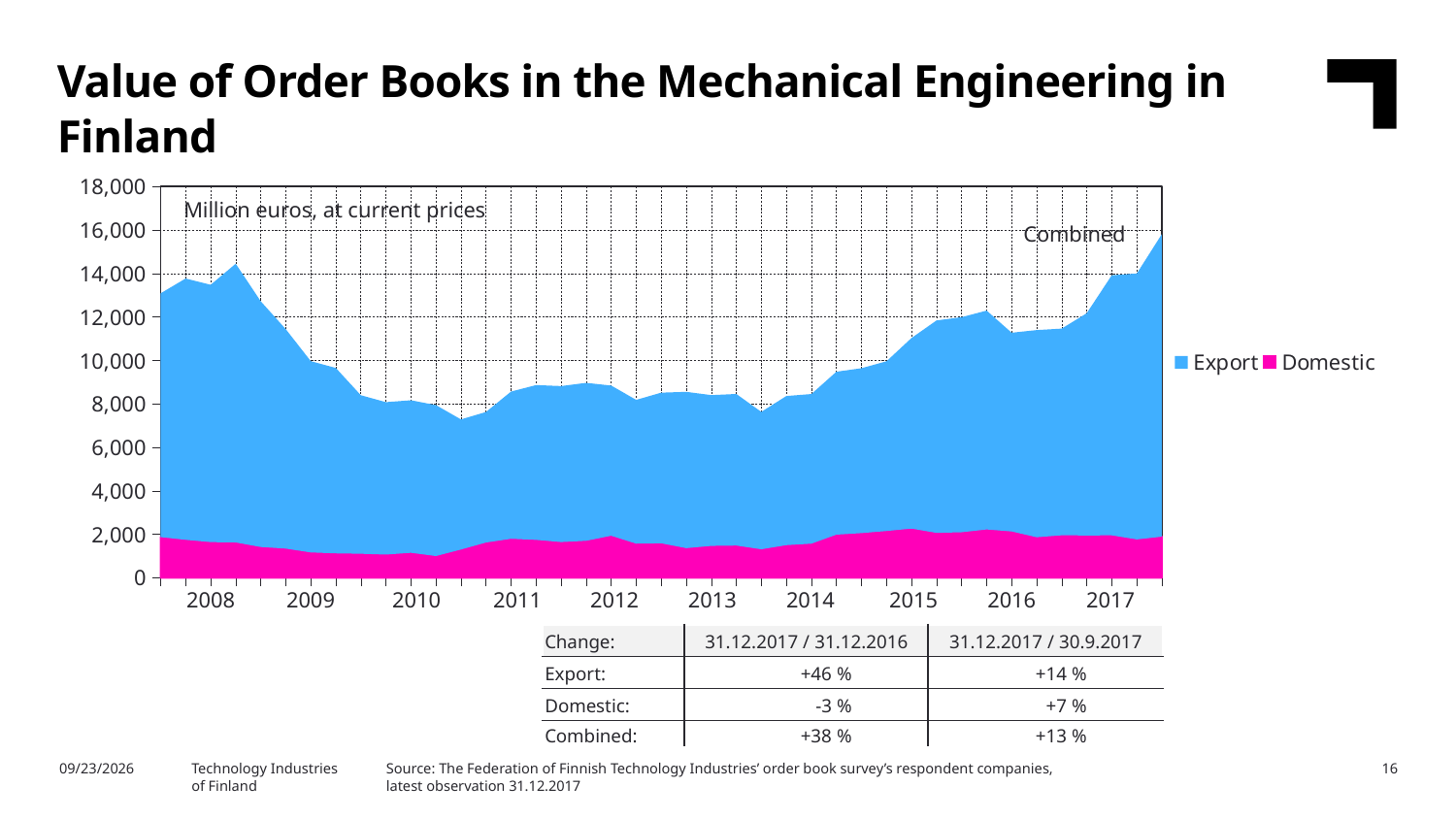
What unit is stated in the annotation inside the chart? Million euros, at current prices Is the combined value at the end of 2017 greater or less than 14,000? greater How many year labels appear on the x axis of the chart? 10 Does the combined value rise or fall between 2016 and the end of 2017? rise How many series does the chart legend list? 2 Does the combined value rise or fall between 2008 and 2010? fall What are the two series named in the chart legend? Export and Domestic What kind of chart is shown on the slide? Stacked area chart Which series is larger throughout the chart, Export or Domestic? Export Is the Domestic value at the end of 2017 greater or less than 4,000? less Is the combined value at the start of 2008 greater or less than 12,000? greater